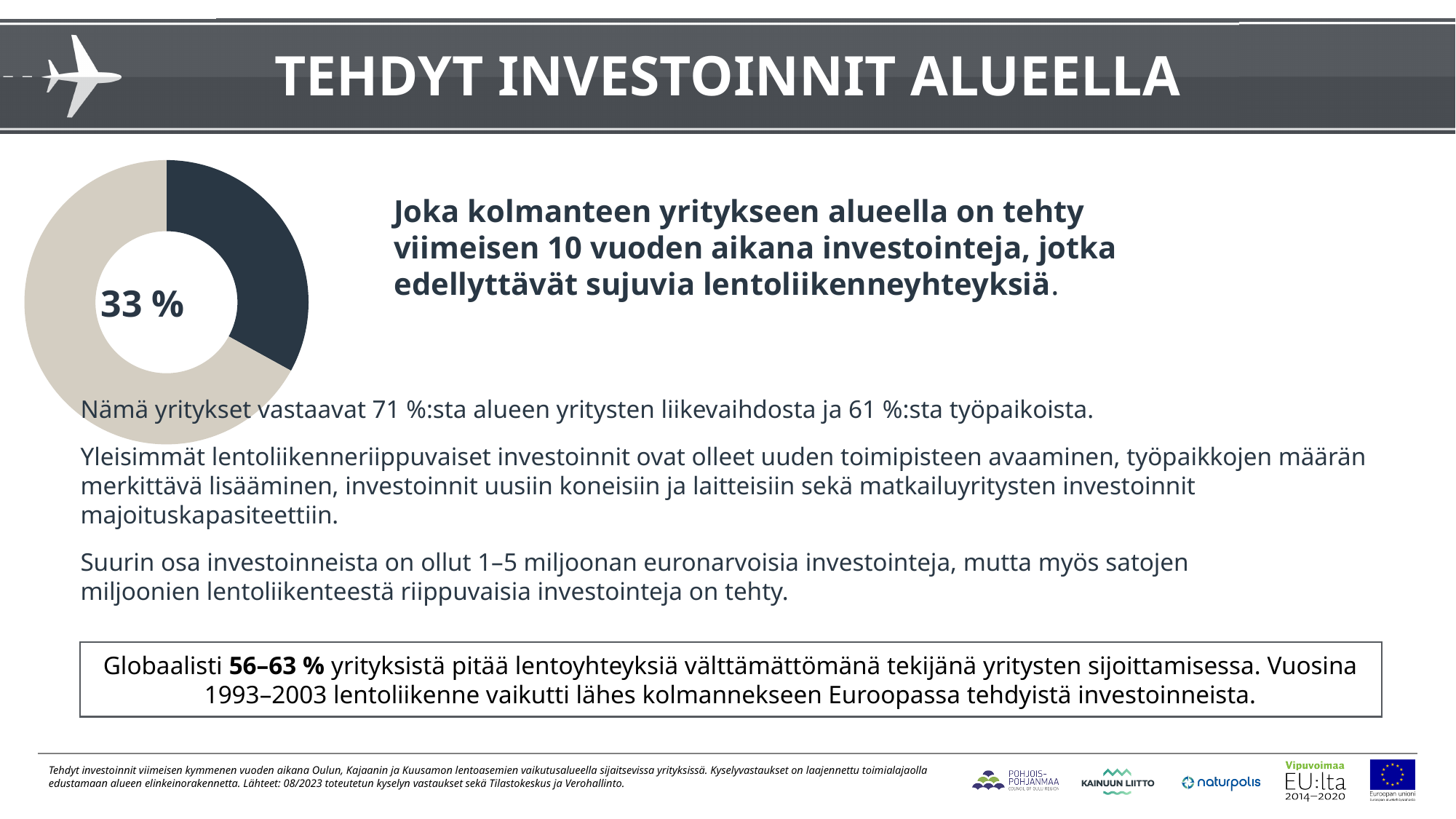
How many slices does the donut chart have? 2 What kind of chart is shown on the left of the slide? donut (pie) chart What colour is the slice of the donut chart that represents 33 %? dark navy Which slice of the donut chart is larger, the dark one or the light beige one? the light beige one What value is printed in the centre of the donut chart? 33 % Does the donut chart have a legend? No What share of the donut chart does the dark slice represent? 33 %